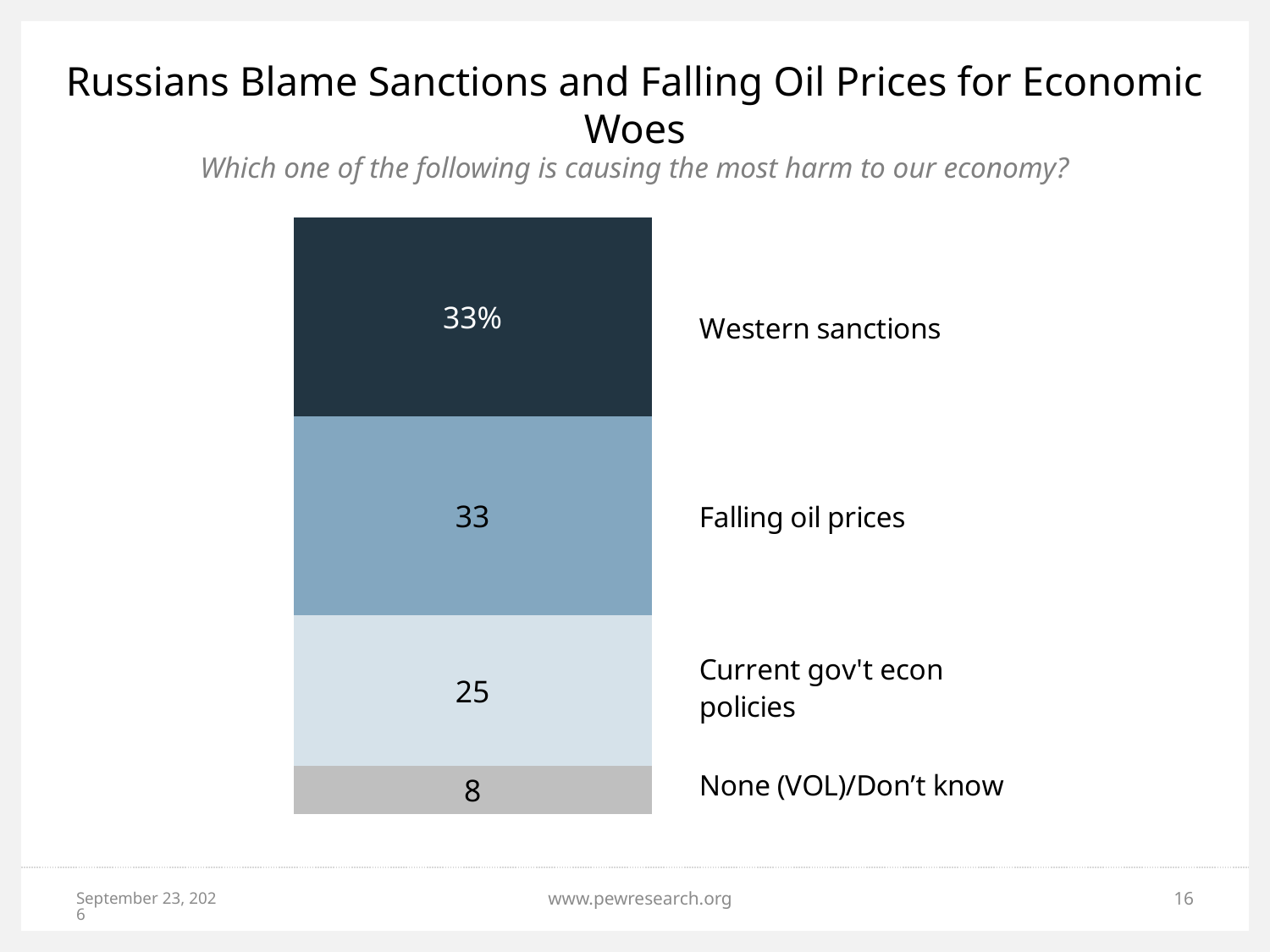
Which is larger, the value for Western sanctions or the value for Current gov't econ policies? Western sanctions What type of chart is shown on the slide? Stacked bar chart What value is shown for None (VOL)/Don't know? 8 What percentage of respondents said Western sanctions are causing the most harm to the economy? 33% What is the difference between the value for Falling oil prices and the value for Current gov't econ policies? 8 What value is shown for Falling oil prices? 33 What value is shown for Current gov't econ policies? 25 How many response categories are shown in the stacked bar? 4 What is the difference between the value for Current gov't econ policies and the value for None (VOL)/Don't know? 17 What is the total of all segments in the stacked bar? 99 Which response has the smallest share in the chart? None (VOL)/Don't know Which is larger, the value for Current gov't econ policies or the value for None (VOL)/Don't know? Current gov't econ policies